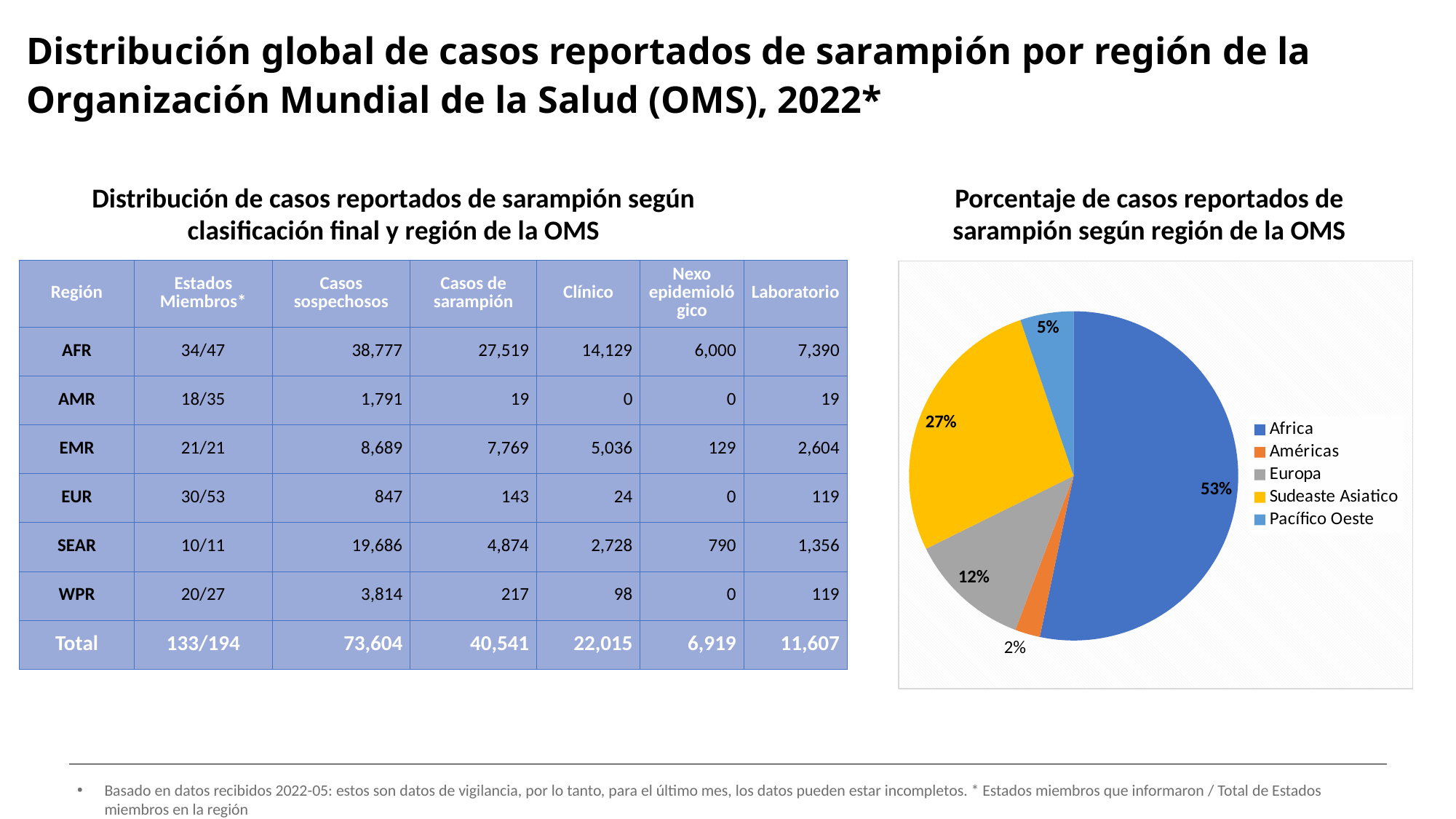
In the pie chart, what percentage is shown for Pacífico Oeste? 5% In the pie chart, which colour represents Sudeaste Asiatico? Yellow What type of chart is used to show the percentage of reported measles cases by WHO region? Pie chart In the pie chart, which has a larger share, Europa or Pacífico Oeste? Europa In the pie chart, which region has the largest share of reported cases? Africa In the pie chart, what share is shown for Sudeaste Asiatico? 27% How many regions are shown in the pie chart legend? 5 In the pie chart, which region has the smallest share of reported cases? Américas In the pie chart, what percentage is labelled for Europa? 12% In the pie chart, what percentage of reported measles cases corresponds to Africa? 53% In the pie chart, what is the difference in percentage points between Africa and Sudeaste Asiatico? 26 In the pie chart, what percentage is shown for Américas? 2%